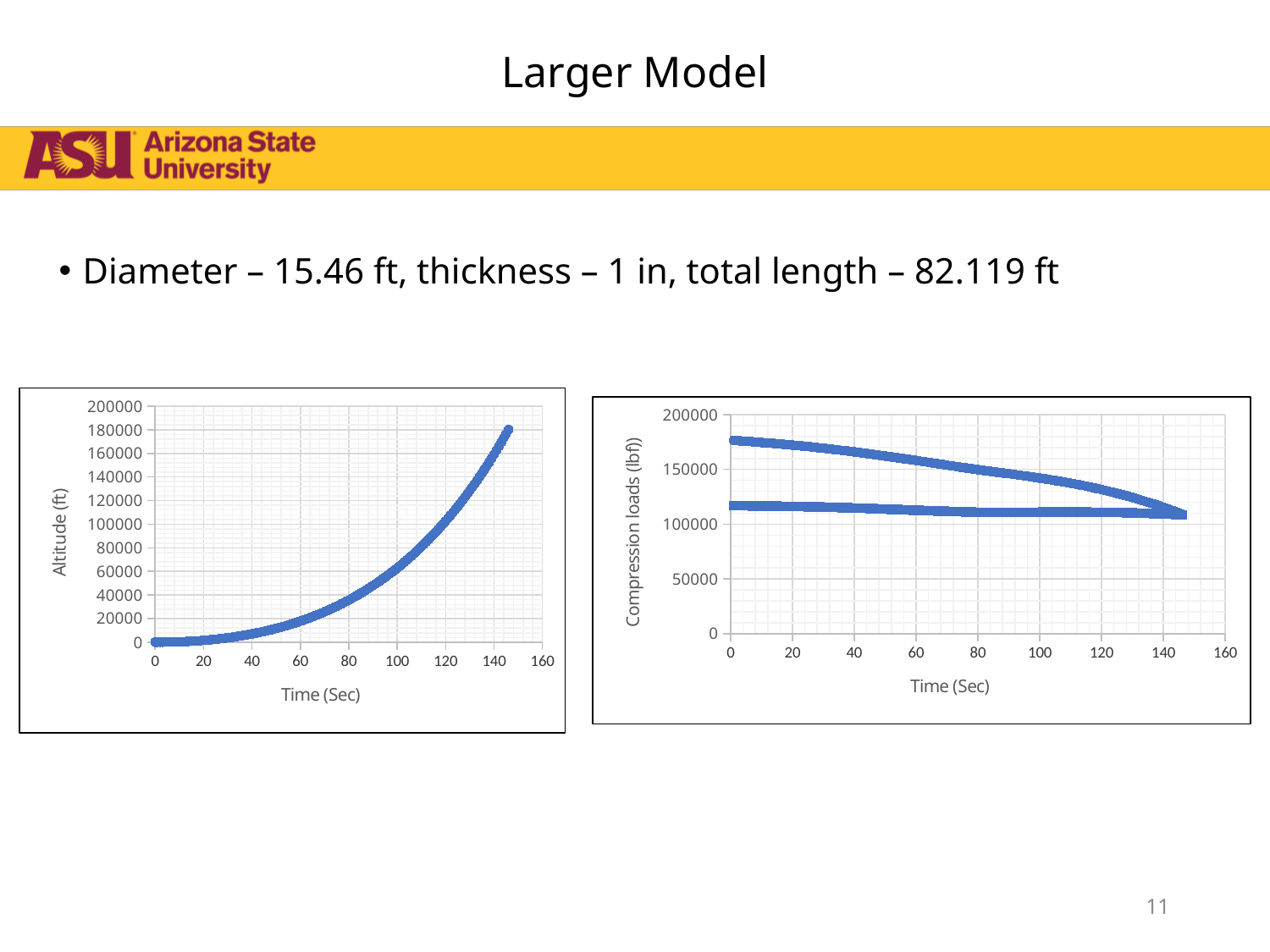
What is the y-axis label of the left chart? Altitude (ft) In the left chart, is the altitude at 60 seconds greater or less than 40000? less What kind of chart is the right chart (Compression loads vs Time)? line chart In the left chart, is the altitude at 100 seconds greater or less than 100000? less In the right chart, is the lower series' compression load at time 0 greater or less than 150000? less In the right chart, does the upper compression-load series rise or fall as time increases? fall In the left chart, does the altitude rise or fall as time increases? rise What kind of chart is the left chart (Altitude vs Time)? line chart What is the y-axis label of the right chart? Compression loads (lbf)